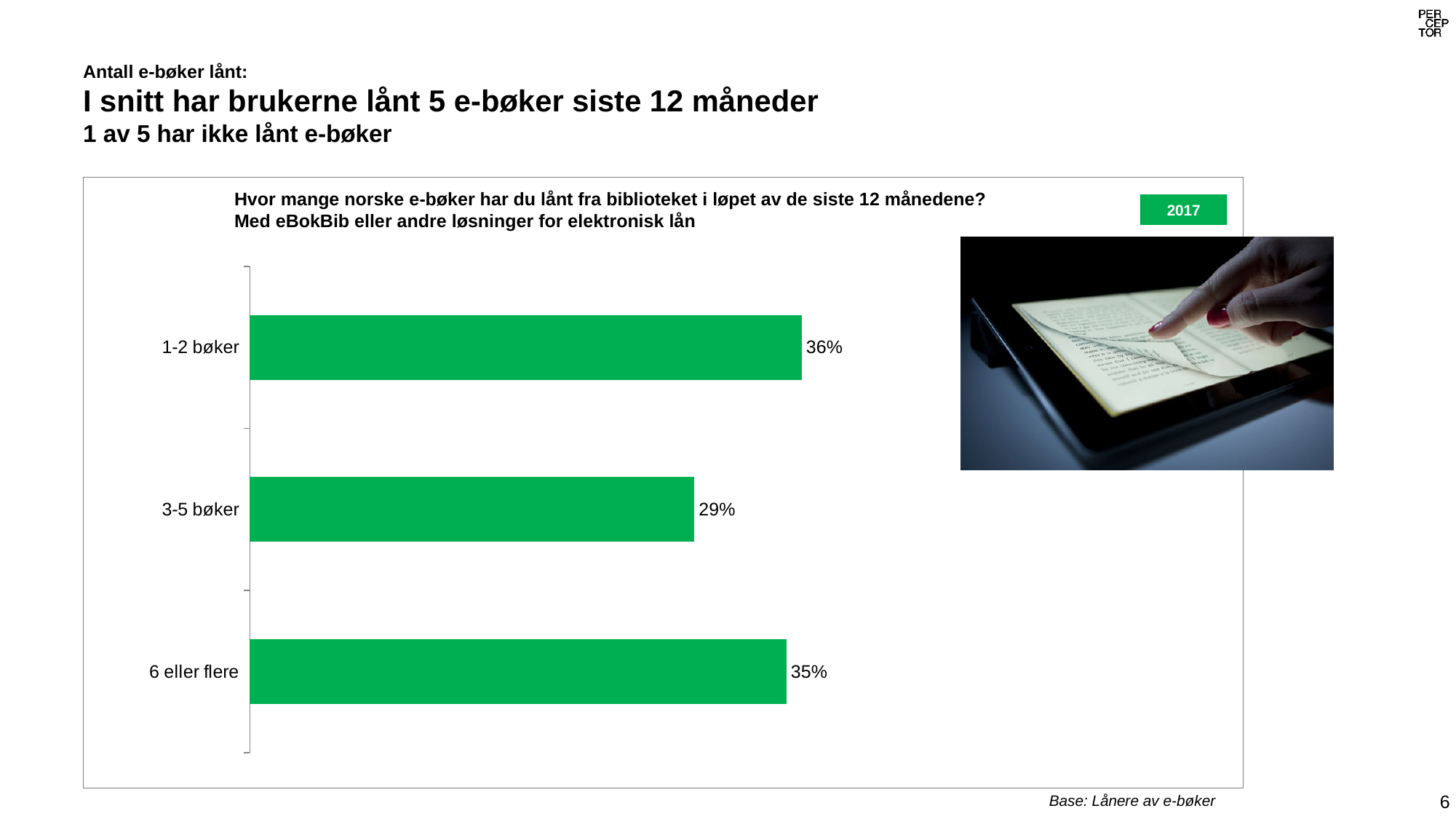
How many categories are shown in the chart? 3 What is the difference between the values for "1-2 bøker" and "3-5 bøker"? 7 percentage points Which year does the chart's legend label indicate? 2017 Which category has the highest value? 1-2 bøker Which is larger, the value for "3-5 bøker" or the value for "6 eller flere"? 6 eller flere What is the value for "3-5 bøker"? 29% What kind of chart is shown on the slide? Bar chart What is the value for "6 eller flere"? 35% Which category has the lowest value? 3-5 bøker What is the difference between the values for "6 eller flere" and "3-5 bøker"? 6 percentage points What is the value for "1-2 bøker"? 36% What colour are the bars in the chart? Green